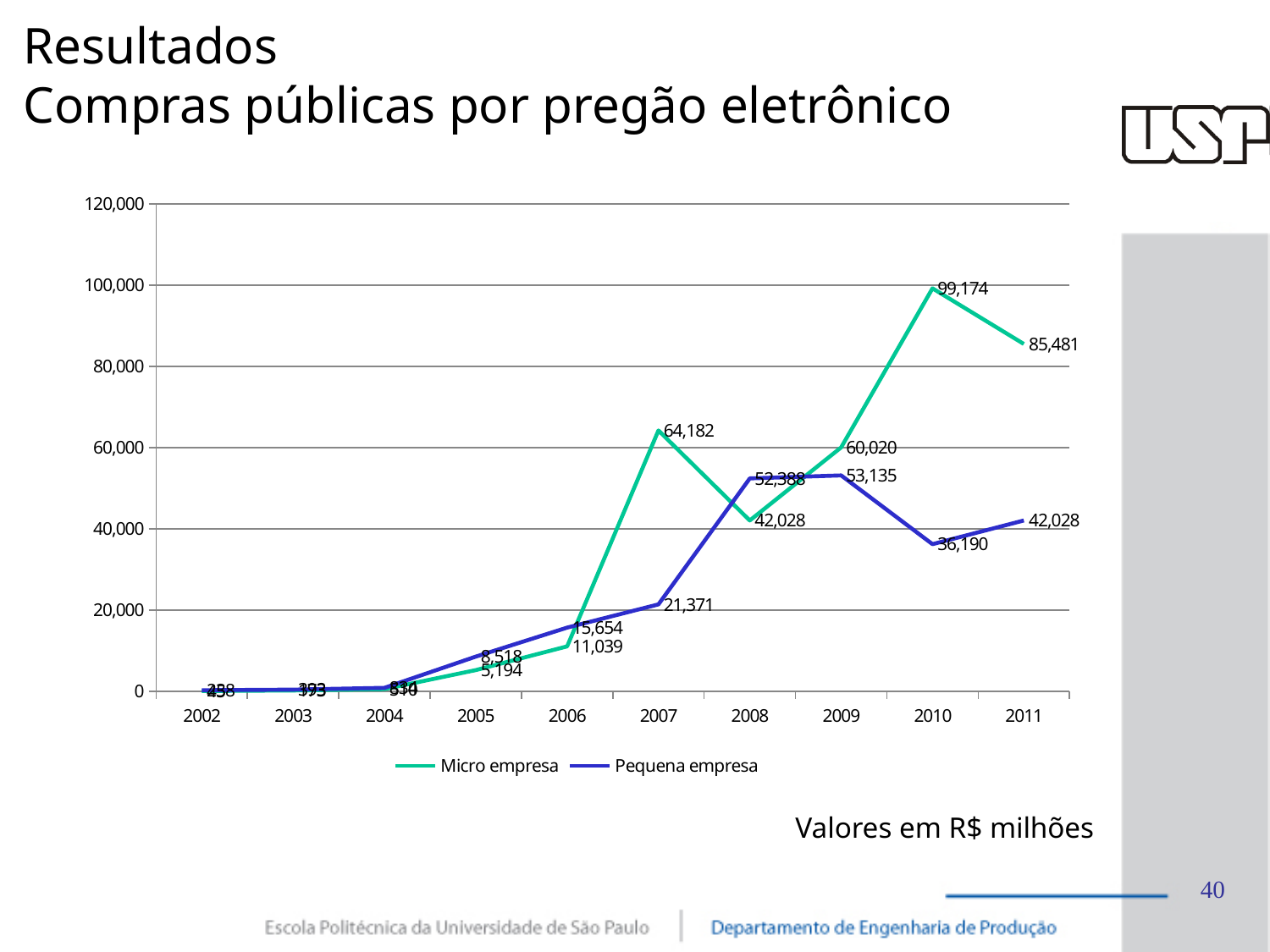
How many years are shown on the x axis? 10 What is the value for Micro empresa in 2010? 99,174 How many series does the legend list? 2 In which year does Pequena empresa reach its highest value? 2009 Which series has the larger value in 2008, Micro empresa or Pequena empresa? Pequena empresa What is the difference between the Micro empresa values for 2010 and 2011? 13,693 In which year does Micro empresa reach its highest value? 2010 What kind of chart is shown on the slide? line chart What unit note is printed below the chart? Valores em R$ milhões Which series has the larger value in 2007, Micro empresa or Pequena empresa? Micro empresa What is the value for Pequena empresa in 2011? 42,028 What is the value for Pequena empresa in 2007? 21,371